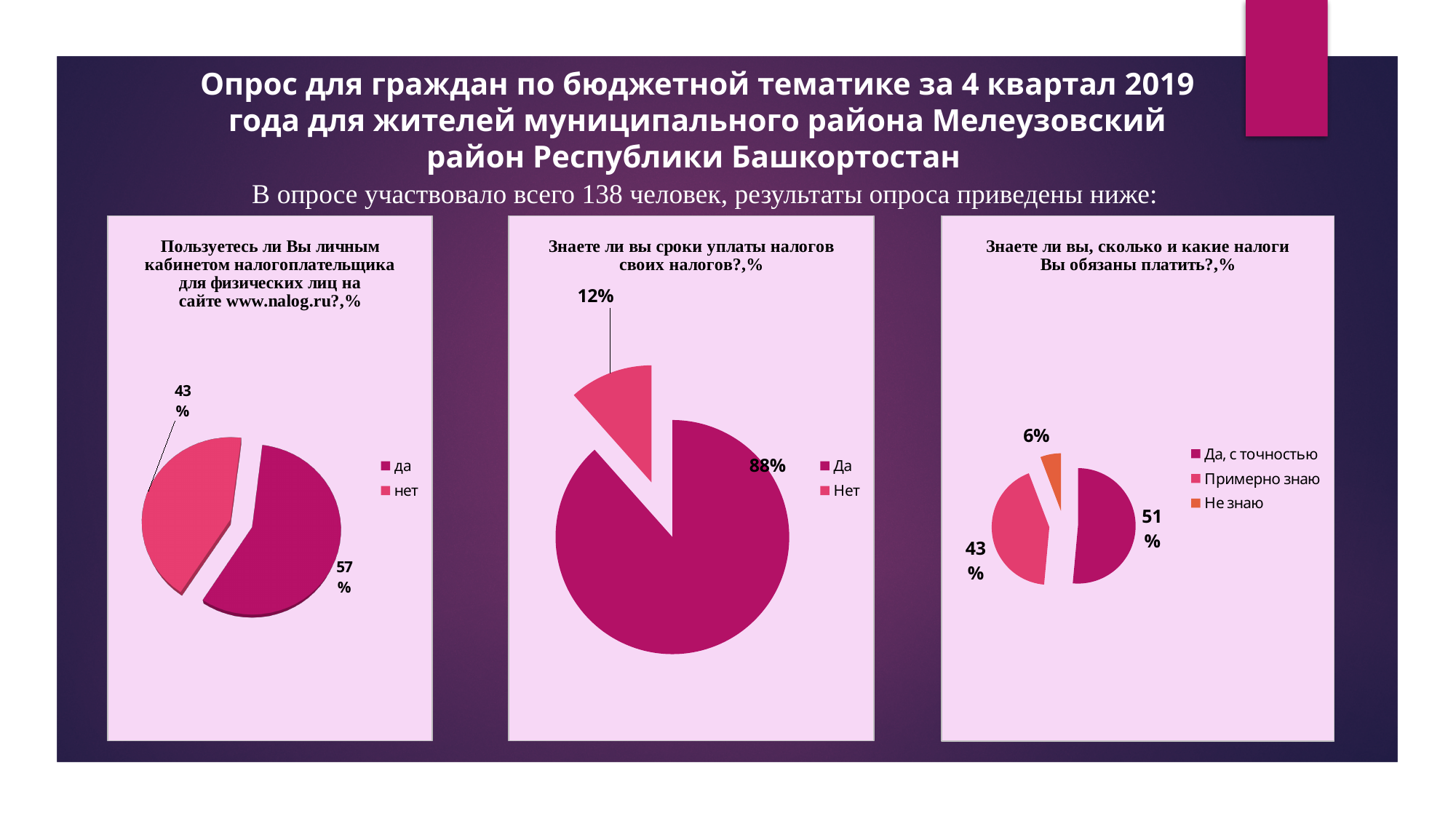
In the right pie chart, which answer has the largest share? Да, с точностью In the middle pie chart, what is the difference between the "Да" and "Нет" shares? 76% In the right pie chart, which answer has the smallest share? Не знаю In the middle pie chart (about knowing tax payment deadlines), what share answered "Нет"? 12% In the left pie chart (about using the taxpayer's personal account on www.nalog.ru), what share answered "да"? 57% In the right pie chart (about knowing which taxes you must pay), what share answered "Да, с точностью"? 51% What type of chart is used in the middle panel of the slide? Pie chart In the left pie chart (about using the taxpayer's personal account on www.nalog.ru), what share answered "нет"? 43% In the middle pie chart (about knowing tax payment deadlines), what share answered "Да"? 88% In the left pie chart, which answer has the larger share, "да" or "нет"? да In the right pie chart (about knowing which taxes you must pay), what share answered "Не знаю"? 6% How many slices does the right pie chart (about knowing which taxes you must pay) have? 3